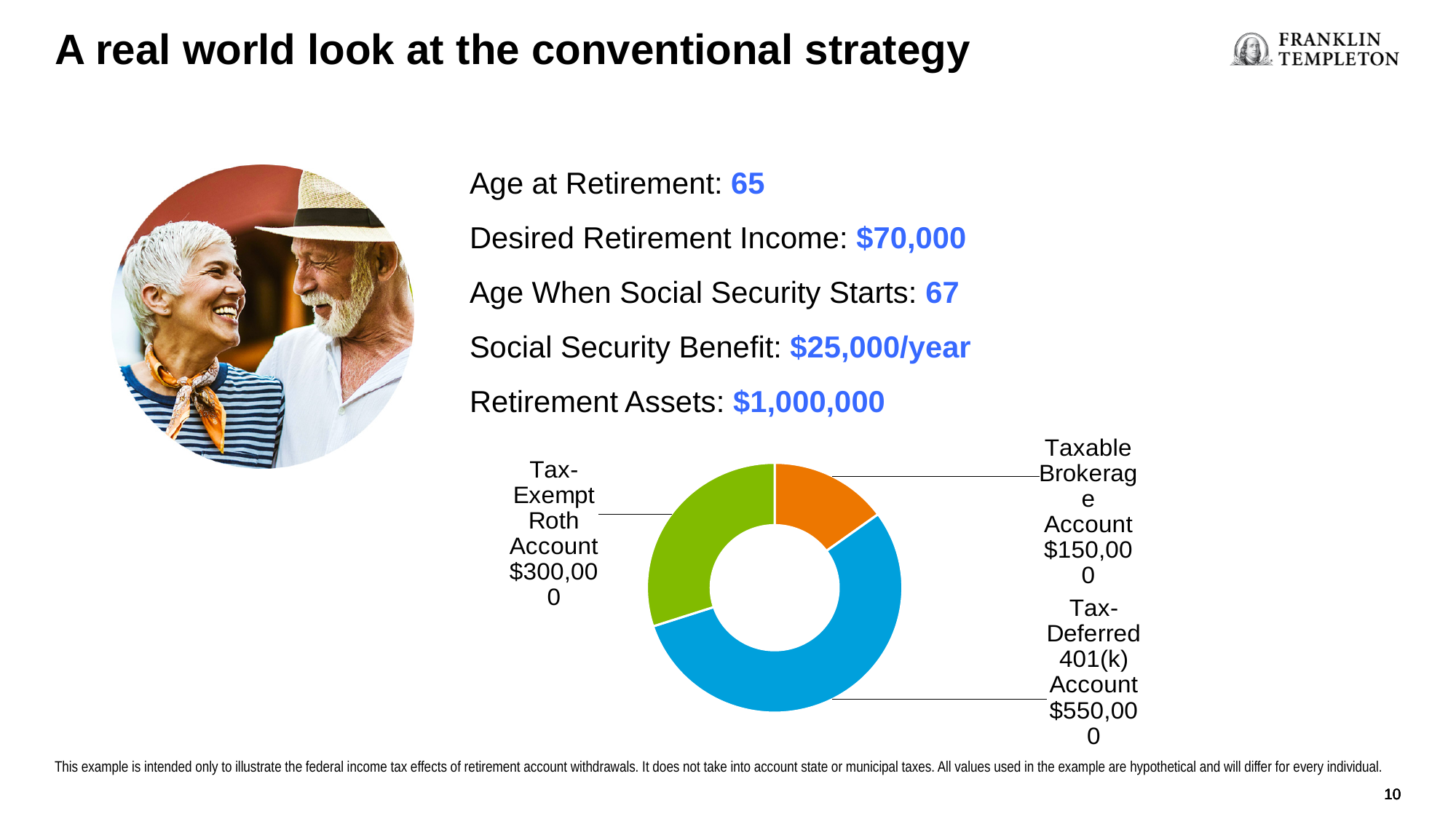
What is the value of the Taxable Brokerage Account slice? $150,000 What is the value of the Tax-Exempt Roth Account slice? $300,000 What is the total of all three slices in the pie chart? $1,000,000 What share of the total does the Tax-Deferred 401(k) Account slice represent? 55% Which is larger, the Tax-Exempt Roth Account or the Taxable Brokerage Account? Tax-Exempt Roth Account Which account has the largest slice in the pie chart? Tax-Deferred 401(k) Account How many slices does the pie chart have? 3 What colour is the Tax-Exempt Roth Account slice? Green What kind of chart is shown on the slide? Pie chart (donut) What is the difference between the Tax-Deferred 401(k) Account and the Tax-Exempt Roth Account values? $250,000 What is the value of the Tax-Deferred 401(k) Account slice? $550,000 Which account has the smallest slice in the pie chart? Taxable Brokerage Account